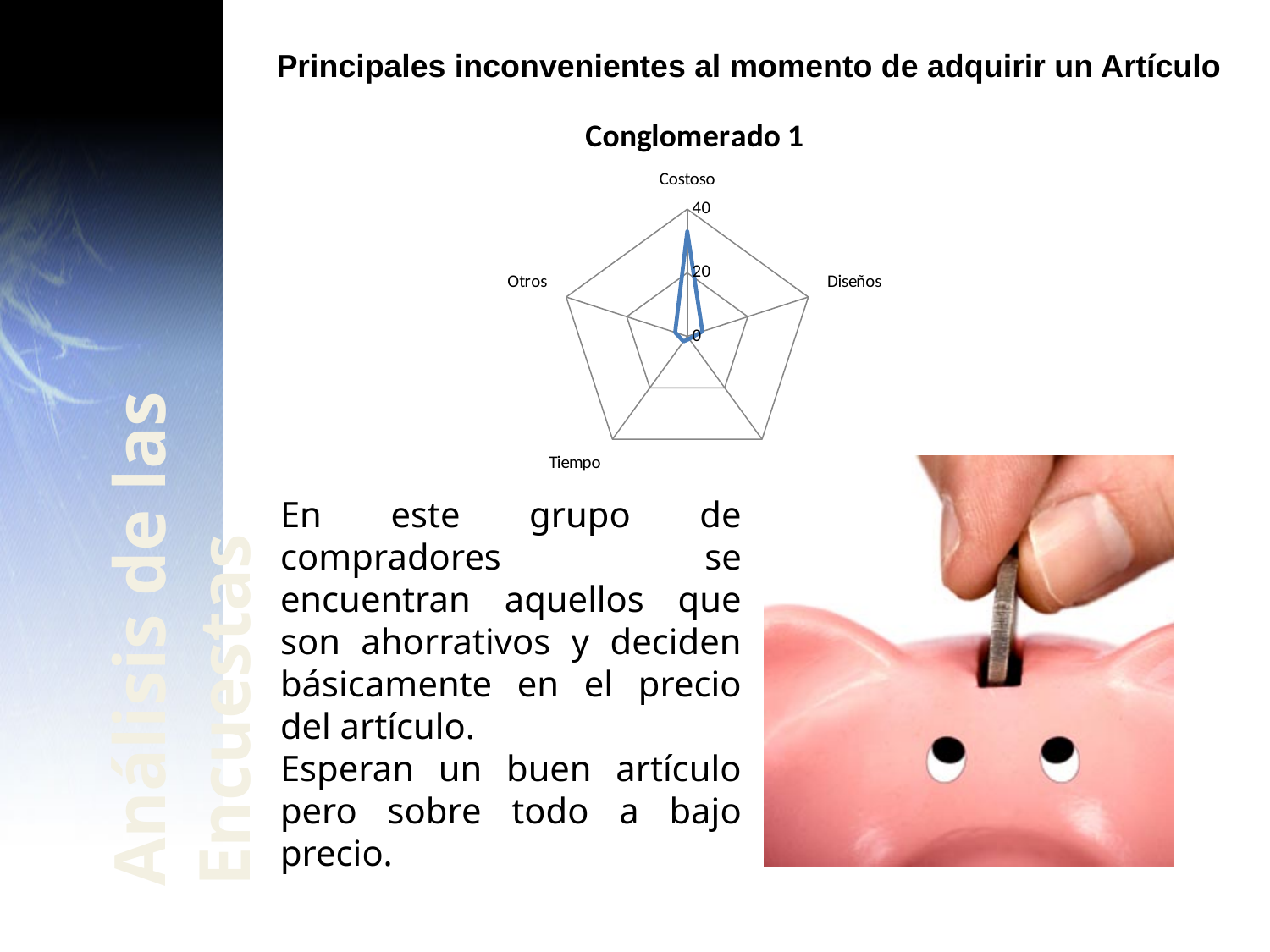
Which is larger, the value for Costoso or the value for Tiempo? Costoso What is the title of the chart on the slide? Conglomerado 1 What kind of chart is shown under the title 'Conglomerado 1'? Radar chart Which is larger, the value for Costoso or the value for Diseños? Costoso Which category has the highest value in the 'Conglomerado 1' chart? Costoso Is the value for Otros greater or less than 20? less What is the highest tick value shown on the chart's axis? 40 Is the value for Diseños greater or less than 20? less Is the value for Costoso greater or less than 20? greater